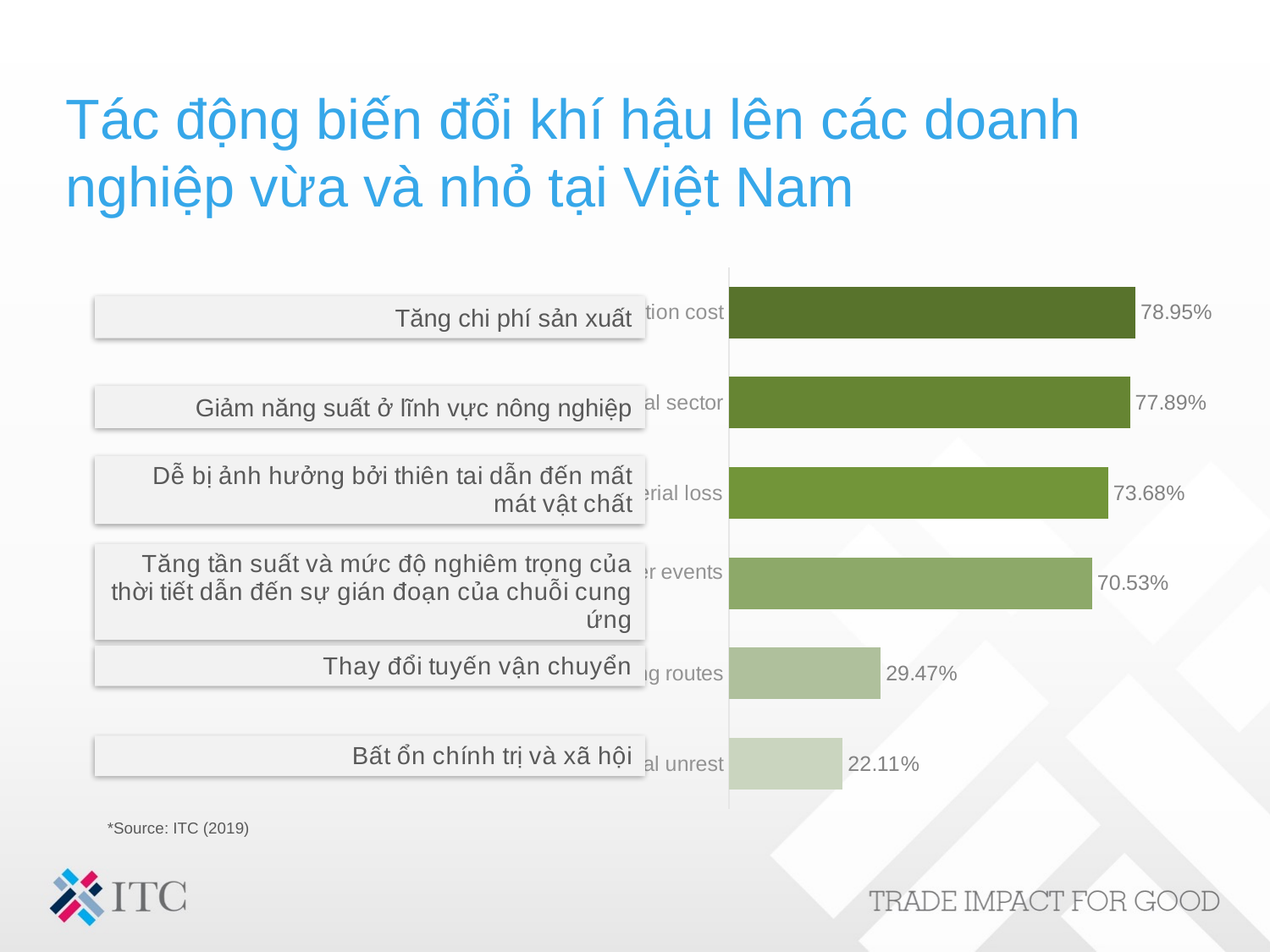
What is the difference between the values for "Tăng chi phí sản xuất" and "Bất ổn chính trị và xã hội"? 56.84% What is the value for "Thay đổi tuyến vận chuyển"? 29.47% What kind of chart is shown on the slide? Bar chart What is the value for the category about increased frequency and severity of weather events disrupting the supply chain ("Tăng tần suất và mức độ nghiêm trọng của thời tiết dẫn đến sự gián đoạn của chuỗi cung ứng")? 70.53% Which is larger: the value for "Dễ bị ảnh hưởng bởi thiên tai dẫn đến mất mát vật chất" or the value for "Thay đổi tuyến vận chuyển"? Dễ bị ảnh hưởng bởi thiên tai dẫn đến mất mát vật chất What source is cited below the chart? ITC (2019) What is the value for "Bất ổn chính trị và xã hội"? 22.11% What is the value for "Giảm năng suất ở lĩnh vực nông nghiệp"? 77.89% What is the value for "Tăng chi phí sản xuất"? 78.95% Which category has the highest value? Tăng chi phí sản xuất How many categories are plotted in the chart? 6 Which category has the lowest value? Bất ổn chính trị và xã hội